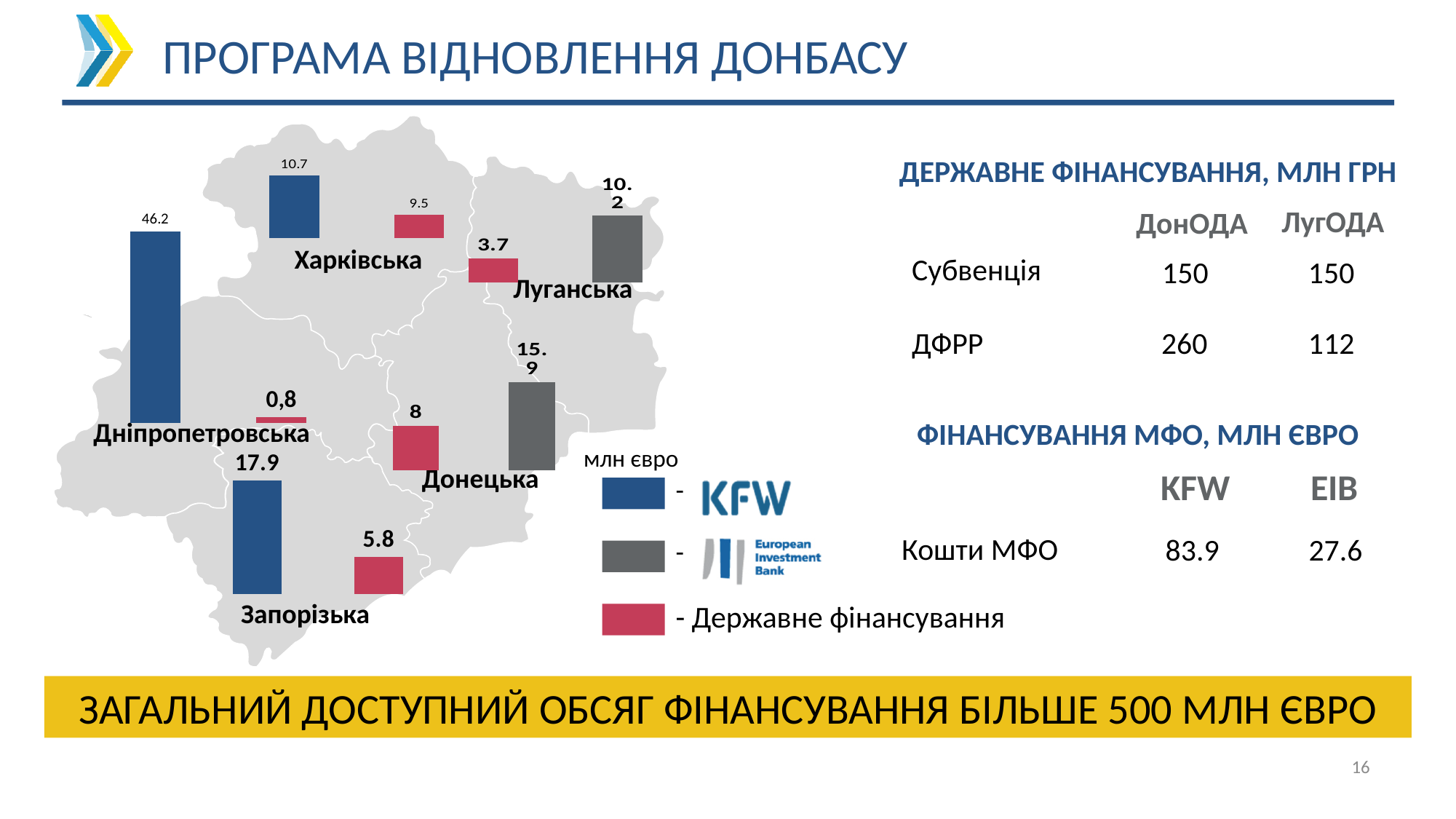
Which region has the larger EIB value, Донецька or Луганська? Донецька Which region has the highest KFW bar on the map? Дніпропетровська What is the Державне фінансування value shown for Луганська? 3.7 What is the KFW value shown for Дніпропетровська? 46.2 What is the Державне фінансування value shown for Харківська? 9.5 Which region has the lowest Державне фінансування bar on the map? Дніпропетровська What kind of chart is overlaid on the map? bar chart What is the total of the KFW and Державне фінансування values for Запорізька? 23.7 What is the European Investment Bank (EIB) value shown for Донецька? 15.9 How many series does the legend of the map chart list? 3 What is the difference between the KFW values for Дніпропетровська and Запорізька? 28.3 In what units are the bar values on the map given, according to the legend? млн євро